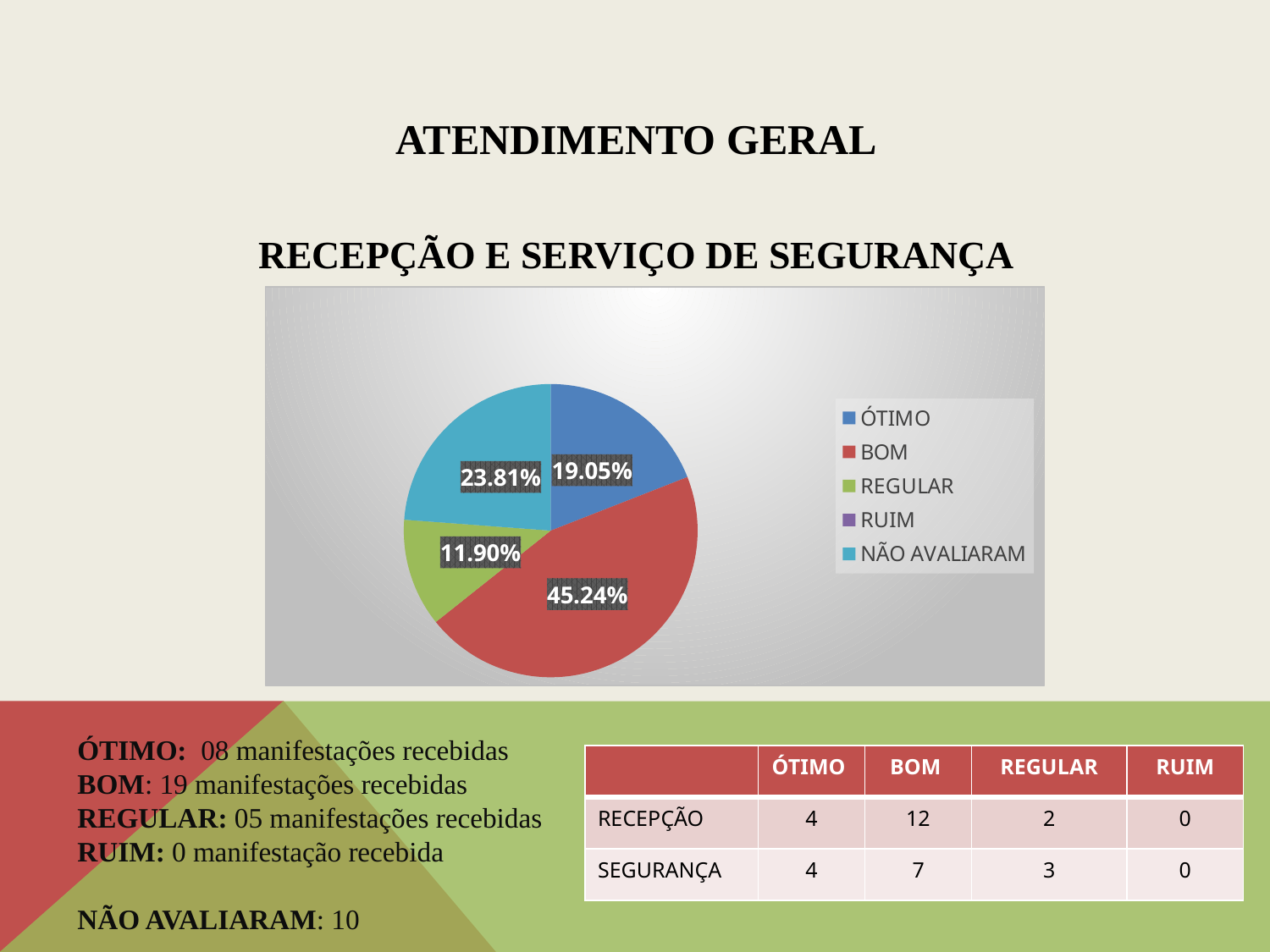
What percentage of the pie chart is labelled for NÃO AVALIARAM? 23.81% What percentage of the pie chart is labelled for REGULAR? 11.90% What percentage of the pie chart is labelled for ÓTIMO? 19.05% Which category has the largest slice of the pie chart? BOM How many categories does the legend of the pie chart list? 5 What colour represents BOM in the pie chart? red Which slice is larger, ÓTIMO or NÃO AVALIARAM? NÃO AVALIARAM Among the slices with a printed percentage label, which category has the smallest share? REGULAR What kind of chart is shown on the slide? pie chart What is the difference in percentage points between the BOM slice and the ÓTIMO slice? 26.19% What percentage of the pie chart is labelled for BOM? 45.24% What is the title shown directly above the pie chart? RECEPÇÃO E SERVIÇO DE SEGURANÇA